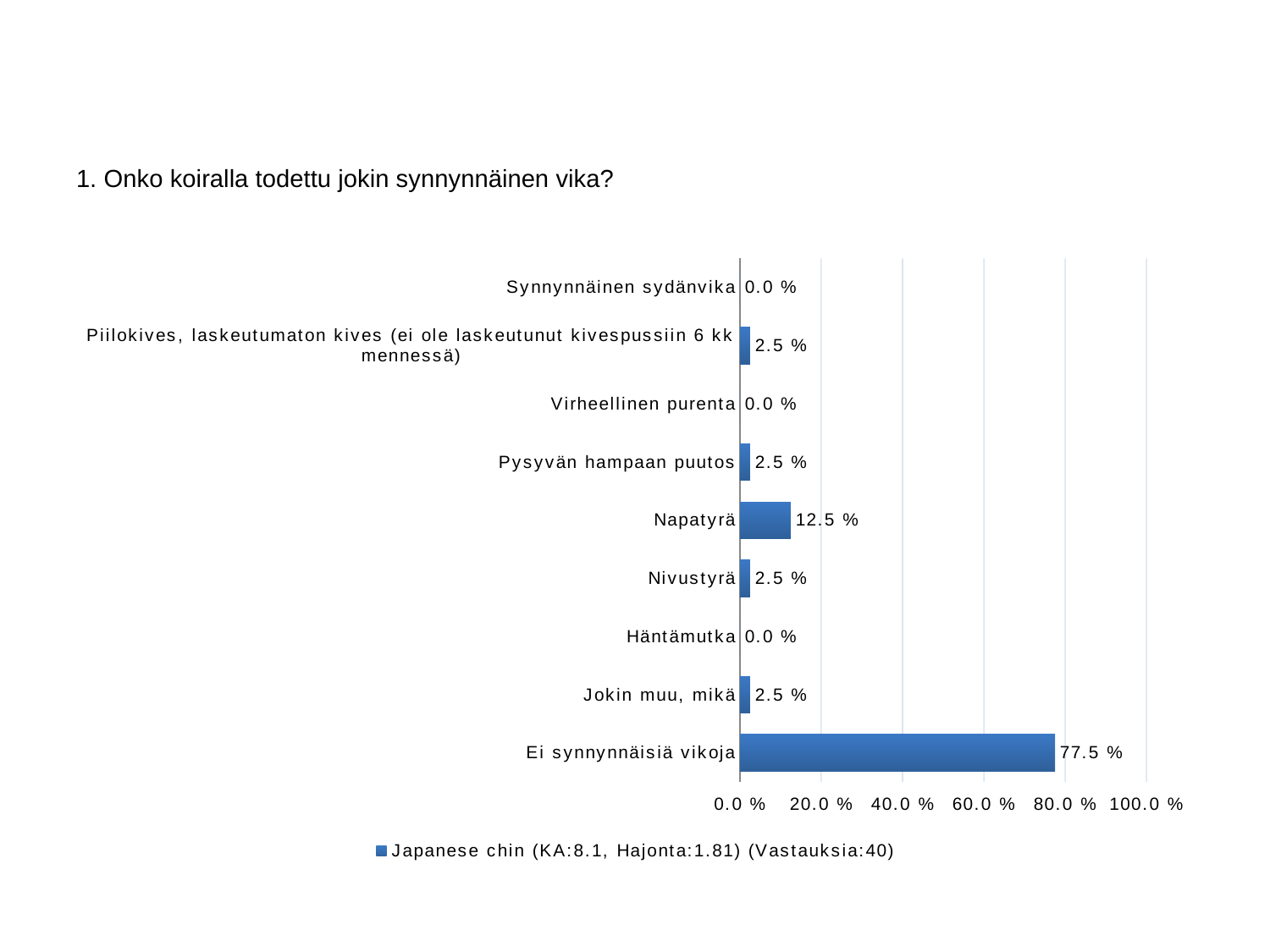
What is the value for Ei synnynnäisiä vikoja? 77.5 % How many series does the legend list? 1 What is the difference between the values for Ei synnynnäisiä vikoja and Napatyrä? 65.0 % What is the value for Napatyrä? 12.5 % What is the difference between the values for Napatyrä and Pysyvän hampaan puutos? 10.0 % What is the value for Nivustyrä? 2.5 % Is the value for Ei synnynnäisiä vikoja greater or less than 60.0 %? greater How many categories are shown on the chart? 9 What kind of chart is shown on the slide? bar chart What is the value for Synnynnäinen sydänvika? 0.0 % Which is larger, the value for Napatyrä or the value for Jokin muu, mikä? Napatyrä Which category has the highest value? Ei synnynnäisiä vikoja